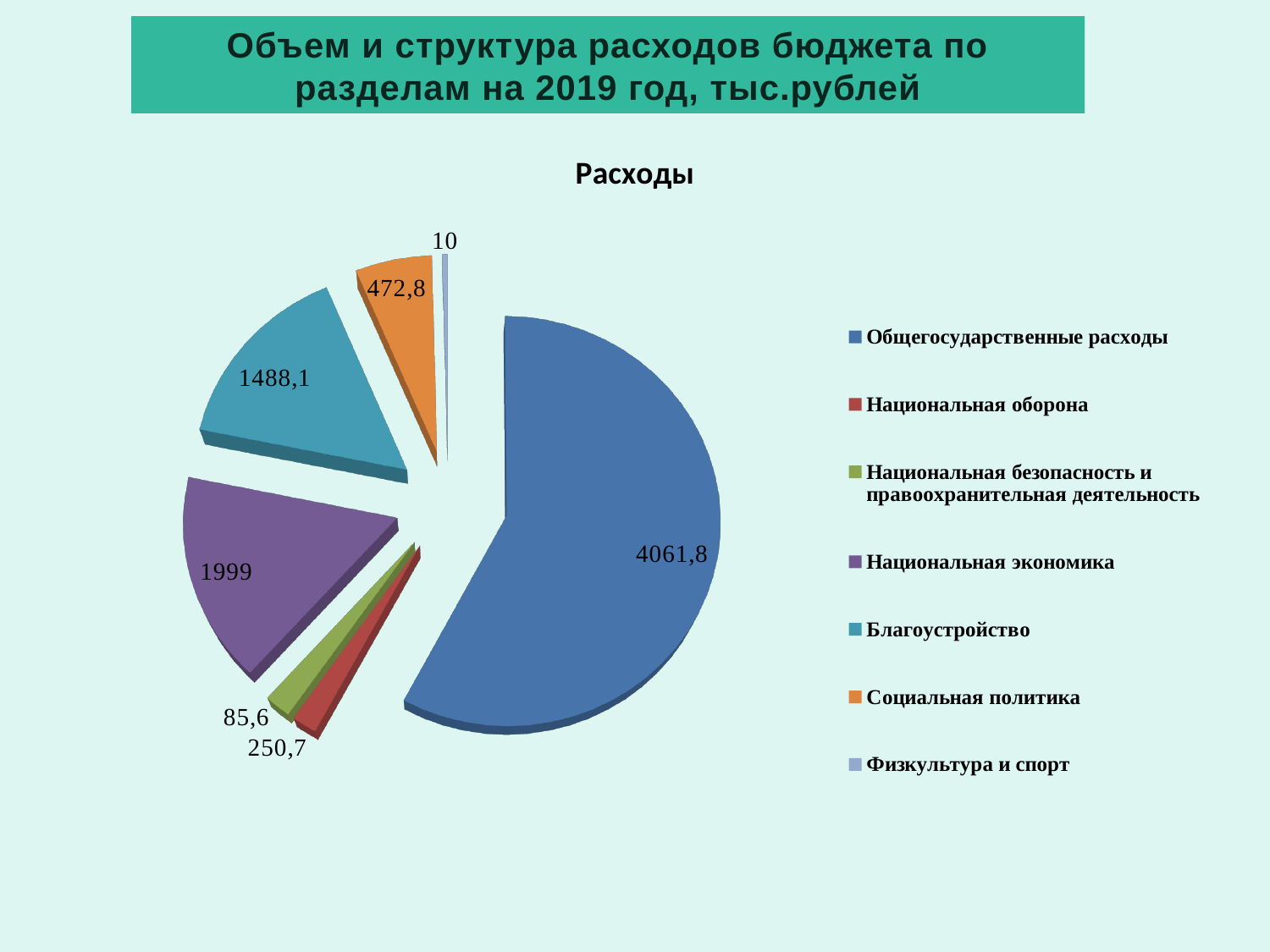
What is the value for Социальная политика? 472,8 What is the title of the chart? Расходы What is the difference between the values for Национальная экономика and Благоустройство? 510,9 What is the difference between the values for Общегосударственные расходы and Национальная экономика? 2062,8 How many categories does the pie chart have? 7 Which is larger: Социальная политика or Национальная оборона? Социальная политика What type of chart is shown on the slide? Pie chart What is the value for Благоустройство? 1488,1 What is the value for Общегосударственные расходы? 4061,8 What is the value for Национальная оборона? 250,7 Which category has the smallest slice of the pie? Физкультура и спорт Which category has the largest slice of the pie? Общегосударственные расходы